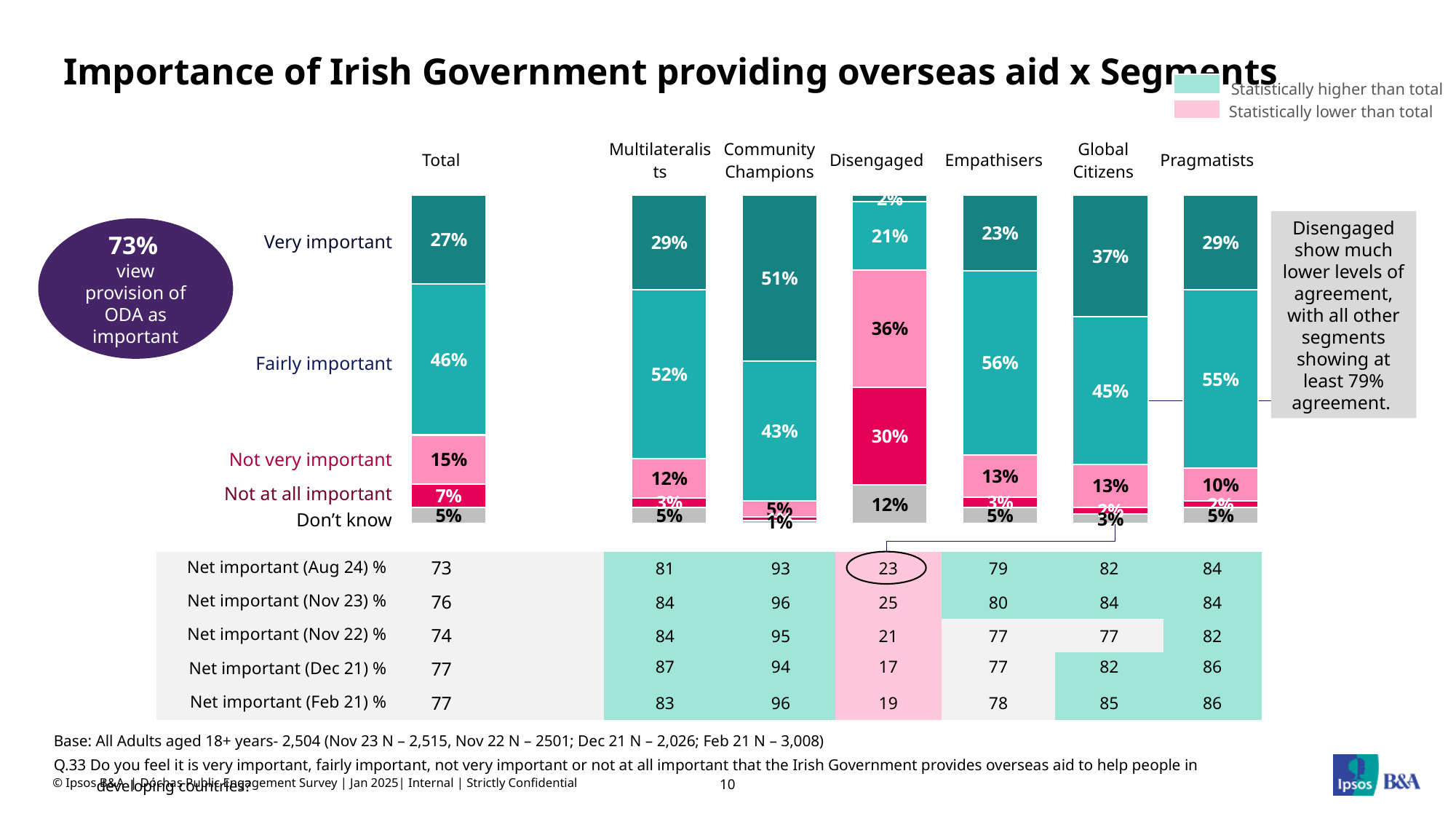
Which is larger: the Not very important share for the Total group or for Multilateralists? Total What does the light pink colour in the legend indicate? Statistically lower than total What is the Net important (Aug 24) % for the Disengaged segment? 23 What percentage of the Disengaged segment say providing overseas aid is Not at all important? 30% What type of chart is used to show the importance ratings by segment? Stacked bar chart How many segment bars are shown in the chart, including Total? 7 What percentage of Empathisers say providing overseas aid is Fairly important? 56% What percentage of Global Citizens say providing overseas aid is Very important? 37% What is the difference between the Fairly important share for Pragmatists and for Multilateralists? 3% Which segment has the lowest share saying Very important? Disengaged Which segment has the highest share saying Very important? Community Champions What percentage of the Total group say providing overseas aid is Very important? 27%